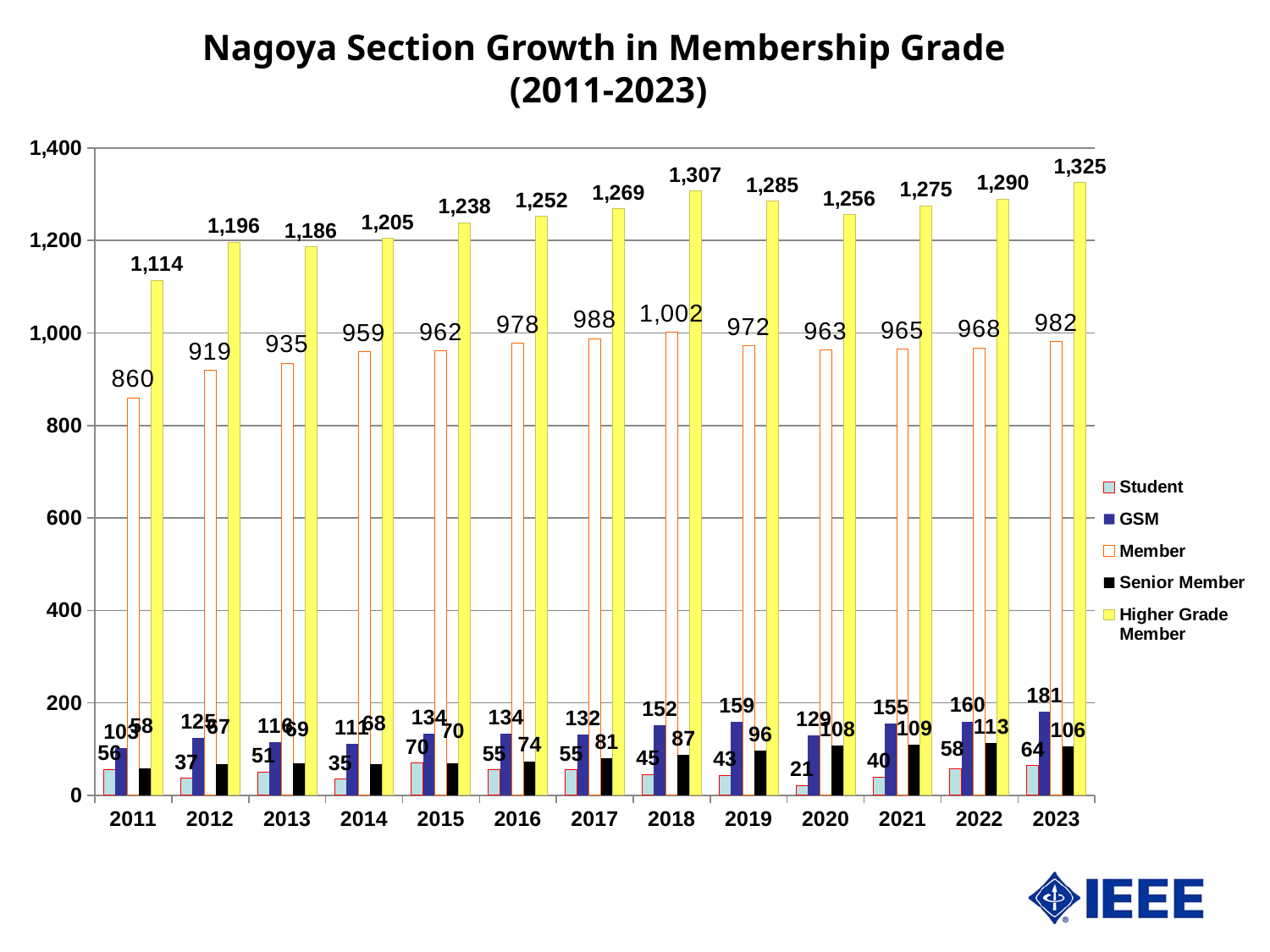
Which year has the larger Member value, 2019 or 2020? 2019 What is the value for Member in 2018? 1,002 In which year is the Higher Grade Member value lowest? 2011 What is the difference between the Higher Grade Member values in 2023 and 2011? 211 How many years are shown on the x axis? 13 What is the value for Higher Grade Member in 2023? 1,325 In which year is the Higher Grade Member value highest? 2023 How many series does the legend list? 5 What is the value for GSM in 2023? 181 What is the value for Student in 2020? 21 What kind of chart is shown on the slide? Bar chart In which year is the Member value highest? 2018